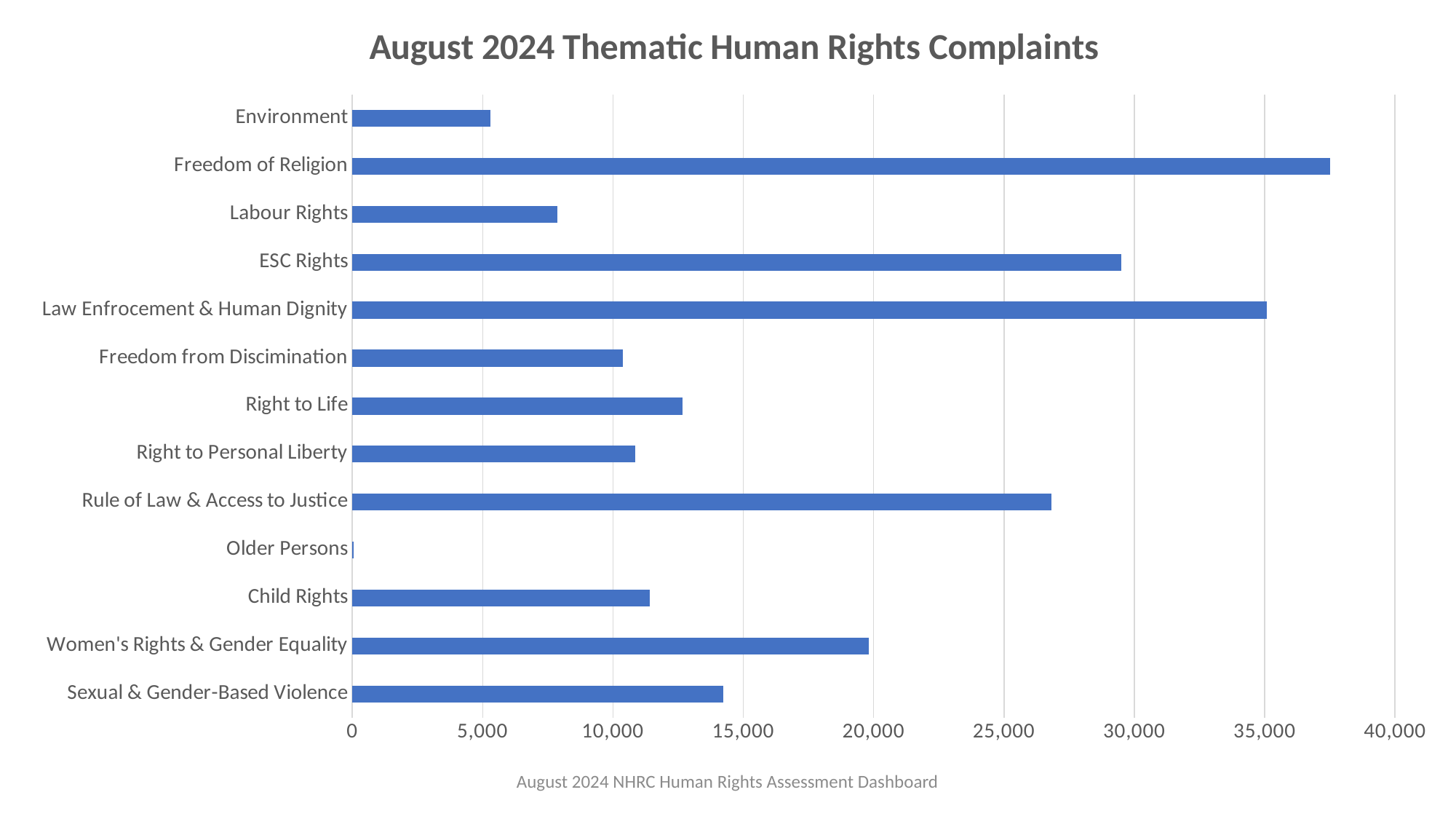
Which category has the lowest number of complaints? Older Persons What source is cited below the chart? August 2024 NHRC Human Rights Assessment Dashboard Which has more complaints, Law Enfrocement & Human Dignity or Rule of Law & Access to Justice? Law Enfrocement & Human Dignity Is the value for Freedom of Religion greater or less than 35,000? greater How many categories are plotted in the chart? 13 What kind of chart is shown on the slide? bar chart What is the title of the chart? August 2024 Thematic Human Rights Complaints Is the value for Environment greater or less than 10,000? less Which has more complaints, Sexual & Gender-Based Violence or Labour Rights? Sexual & Gender-Based Violence Is the value for ESC Rights greater or less than 25,000? greater Which category has the highest number of complaints? Freedom of Religion